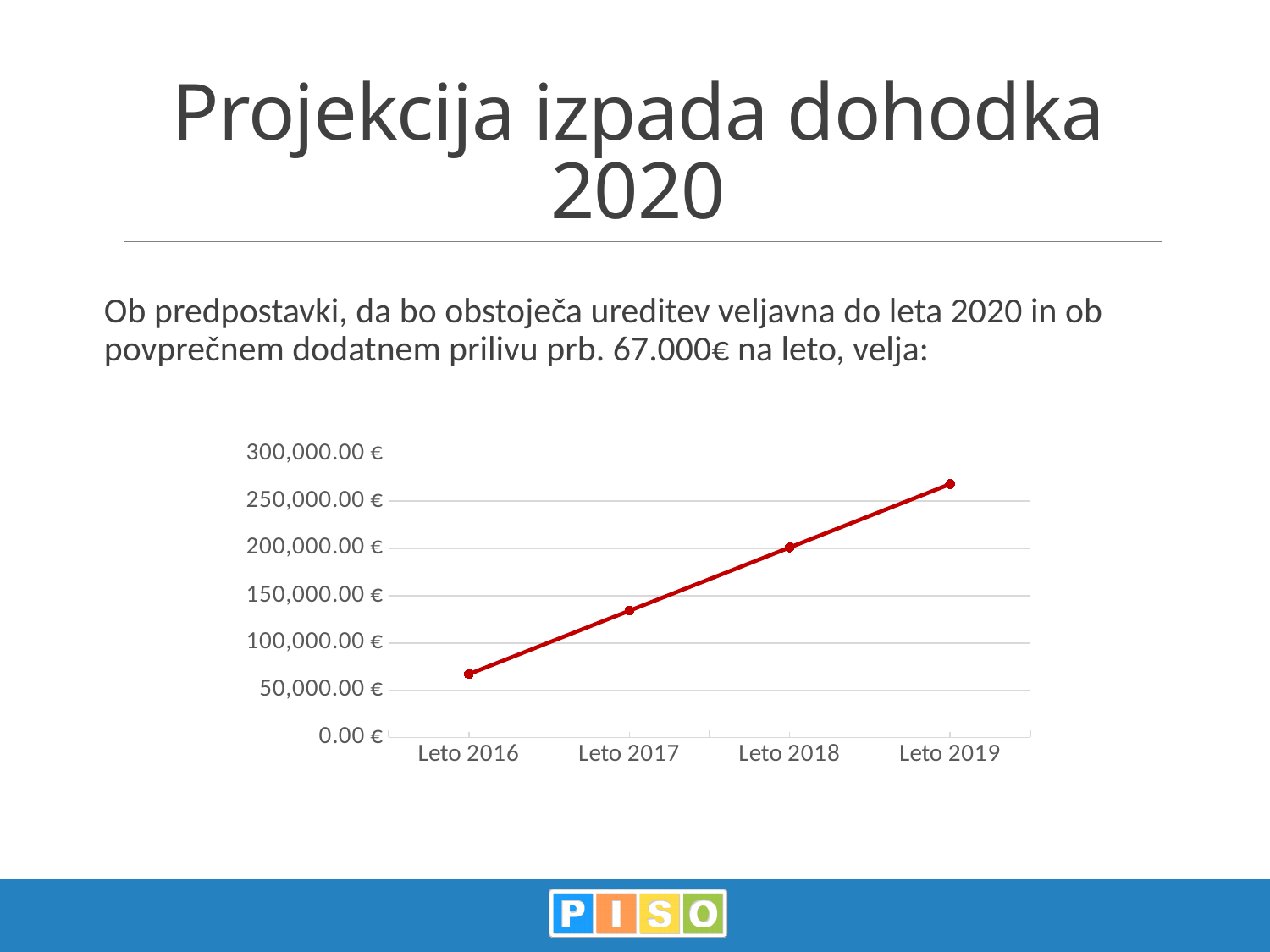
Which year has the highest value on the chart? Leto 2019 What kind of chart is shown on the slide? line chart Is the value for Leto 2019 greater or less than 250,000.00 €? greater How many data points are plotted on the chart? 4 Is the value for Leto 2016 greater or less than 100,000.00 €? less What colour is the line on the chart? red Is the value for Leto 2017 greater or less than 150,000.00 €? less Do the values rise or fall from Leto 2016 to Leto 2019? rise Which is larger, the value for Leto 2017 or the value for Leto 2018? Leto 2018 What is the highest value shown on the vertical axis? 300,000.00 € Which year has the lowest value on the chart? Leto 2016